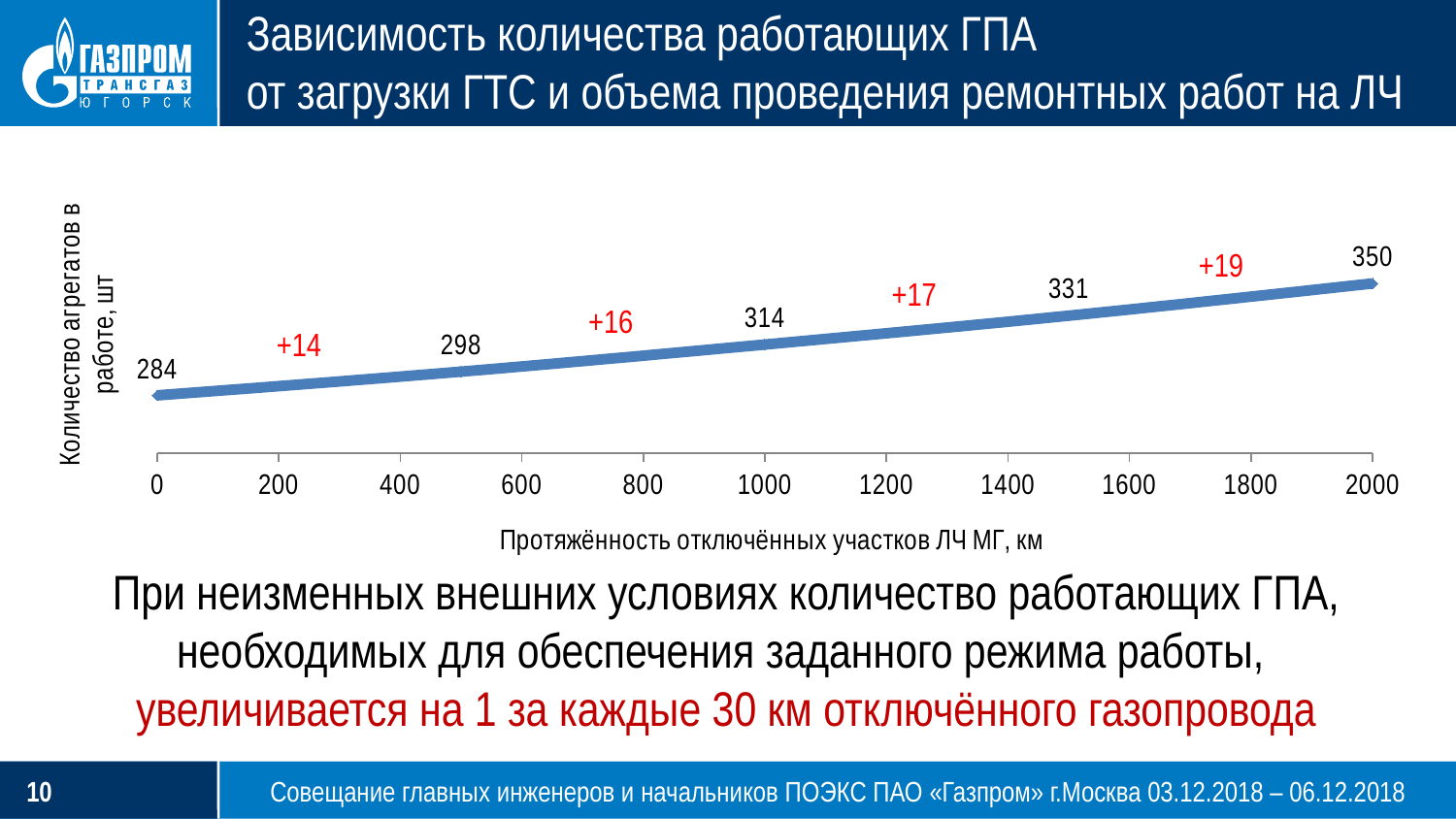
What is the number of working units at 0 km of disconnected sections? 284 What is the difference between the value at 2000 km and the value at 0 km? 66 What is the lowest value labelled on the line? 284 Does the number of working units rise or fall as the length of disconnected sections increases? rises What increment is shown in red between the first two labelled points (284 and 298)? +14 What is the title of the x axis? Протяжённость отключённых участков ЛЧ МГ, км What is the highest value labelled on the line? 350 How many data points are labelled on the line? 5 What is the number of working units at 2000 km of disconnected sections? 350 What type of chart is shown on the slide? line chart What is the number of working units at 1000 km of disconnected sections? 314 Which is larger: the value labelled 331 or the value labelled 314? 331